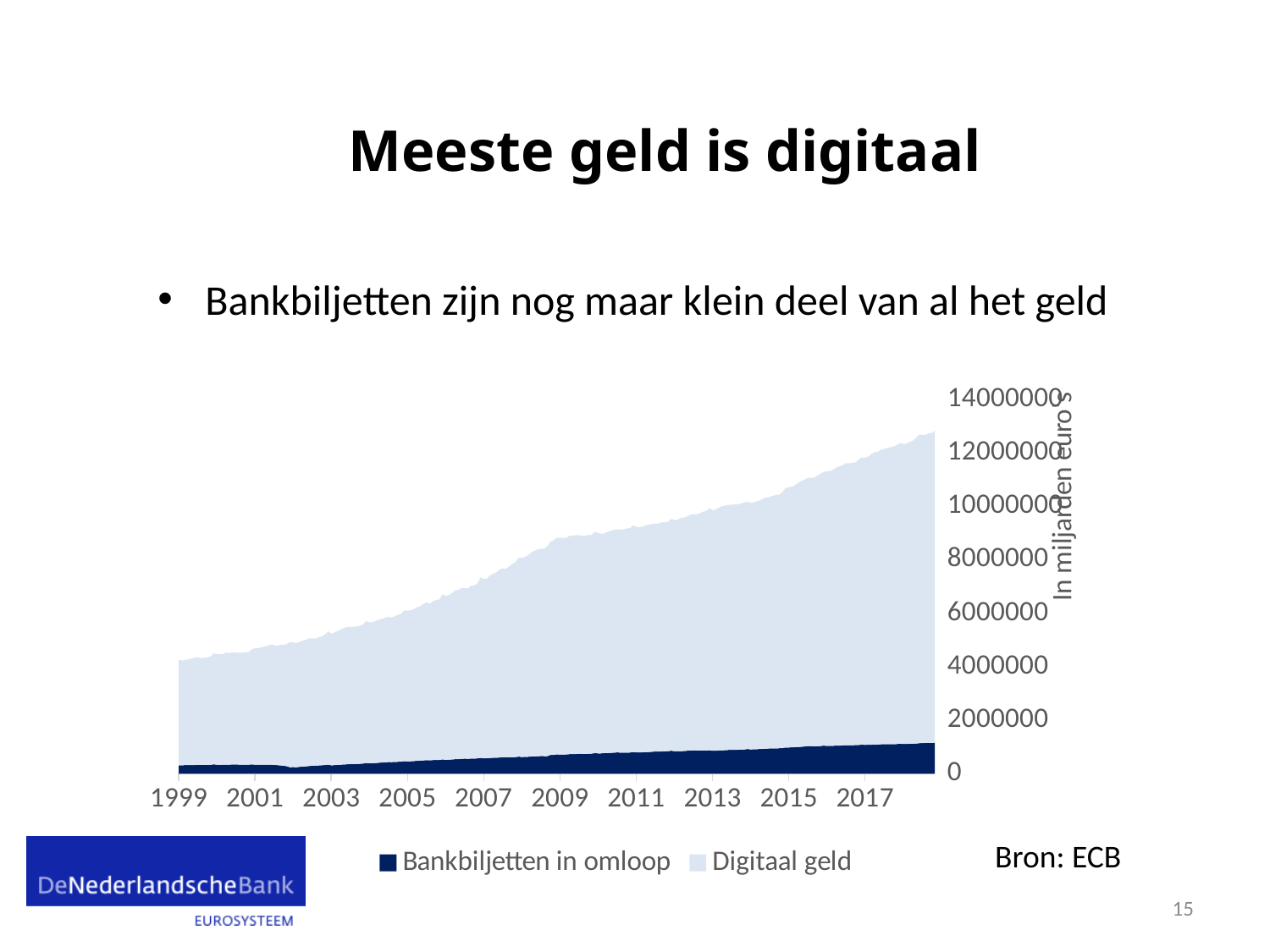
Is the total value (top of the stacked area) in 2017 greater or less than 10000000? greater Does the total amount of money in the chart rise or fall from 1999 to 2017? Rise What is the label on the vertical axis of the chart? In miljarden euro's Is the total value (top of the stacked area) in 1999 greater or less than 6000000? less Is the value for Bankbiljetten in omloop in 2017 greater or less than 2000000? less Which series is larger in 2017, Bankbiljetten in omloop or Digitaal geld? Digitaal geld How many year labels are shown on the x axis of the chart? 10 What is the first year label shown on the x axis of the chart? 1999 What kind of chart is shown on the slide? Stacked area chart How many series does the chart legend list? 2 Which two series are listed in the chart legend? Bankbiljetten in omloop and Digitaal geld